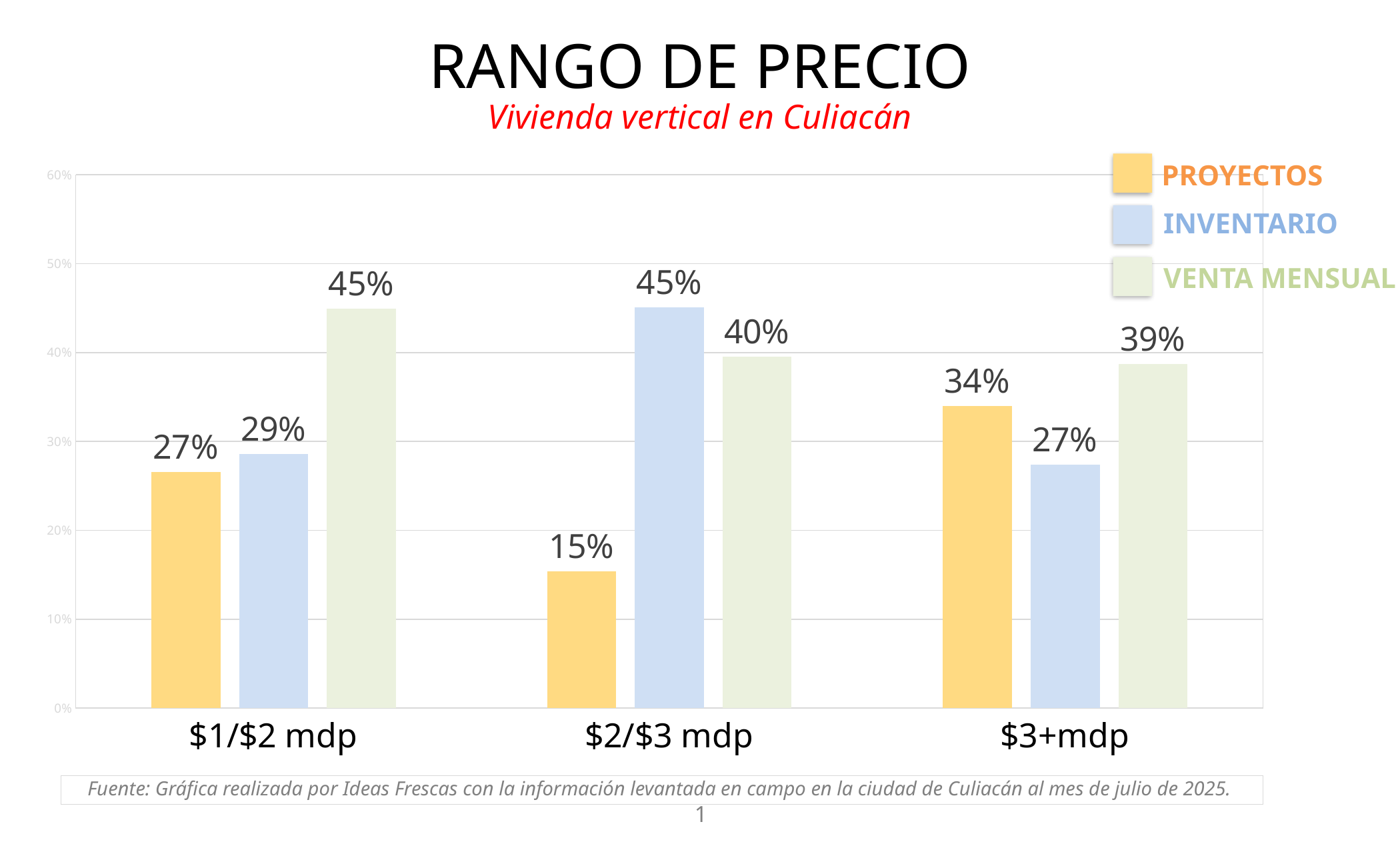
How many series does the legend list? 3 What kind of chart is shown on the slide? Bar chart How many price range categories are shown on the x axis? 3 Is the VENTA MENSUAL value for the $2/$3 mdp price range greater or less than 30%? greater What is the difference between the INVENTARIO and PROYECTOS values for the $2/$3 mdp price range? 30% Which price range has the lowest INVENTARIO value? $3+mdp What is the INVENTARIO value for the $1/$2 mdp price range? 29% What is the PROYECTOS value for the $2/$3 mdp price range? 15% Which is larger for the $3+mdp price range: PROYECTOS or INVENTARIO? PROYECTOS Which price range has the highest PROYECTOS value? $3+mdp What is the VENTA MENSUAL value for the $3+mdp price range? 39% What is the title of the chart? RANGO DE PRECIO